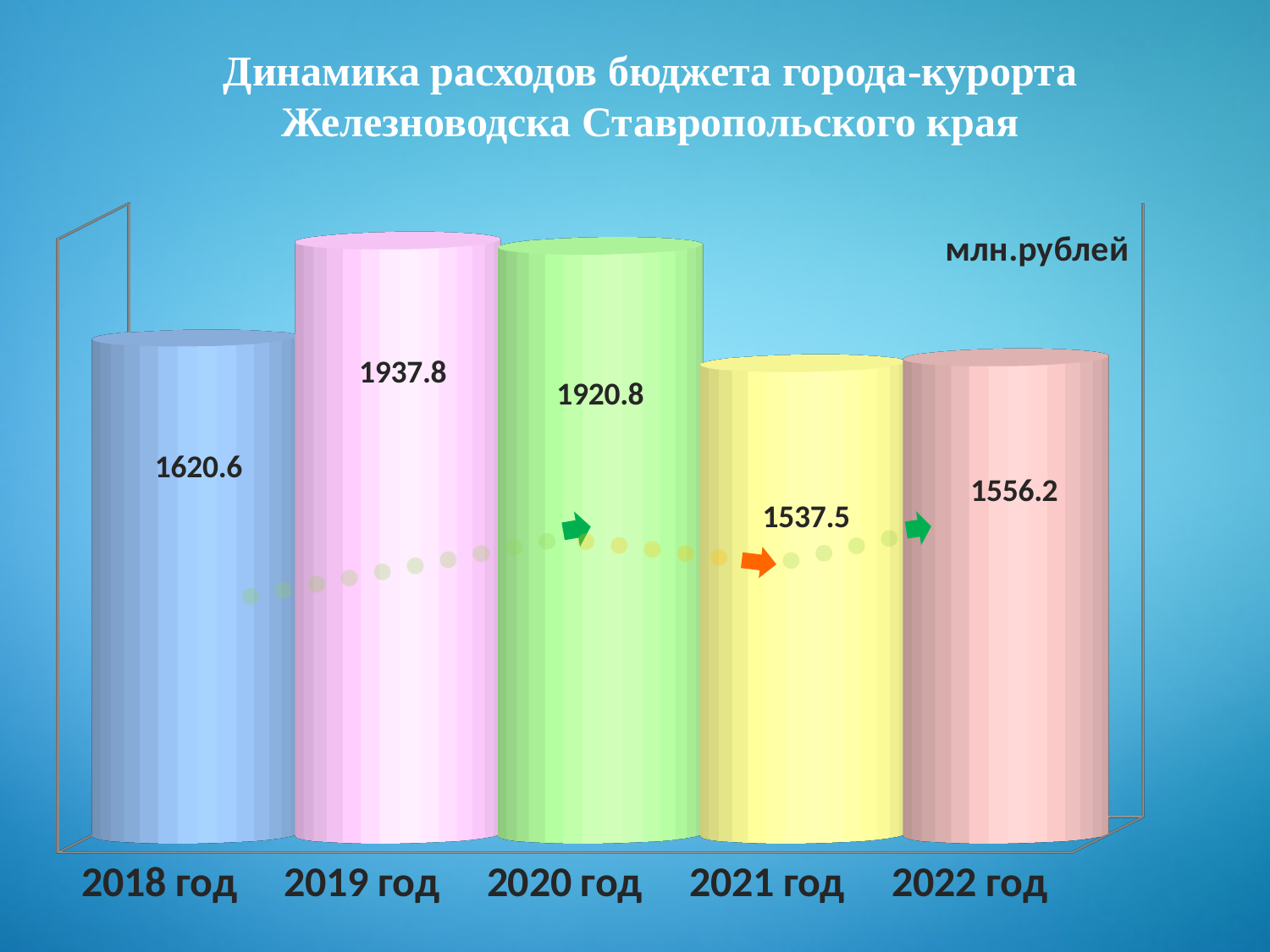
What is the value for 2022 год? 1556.2 What kind of chart is shown on the slide? bar chart What is the value for 2018 год? 1620.6 Do the values rise or fall from 2020 год to 2021 год? fall Which year has the highest value? 2019 год How many years are shown on the chart? 5 What unit of measurement is indicated on the chart? млн.рублей Which is larger, the value for 2020 год or the value for 2022 год? 2020 год What is the difference between the values for 2020 год and 2021 год? 383.3 What is the difference between the values for 2019 год and 2018 год? 317.2 What is the value for 2021 год? 1537.5 Which year has the lowest value? 2021 год